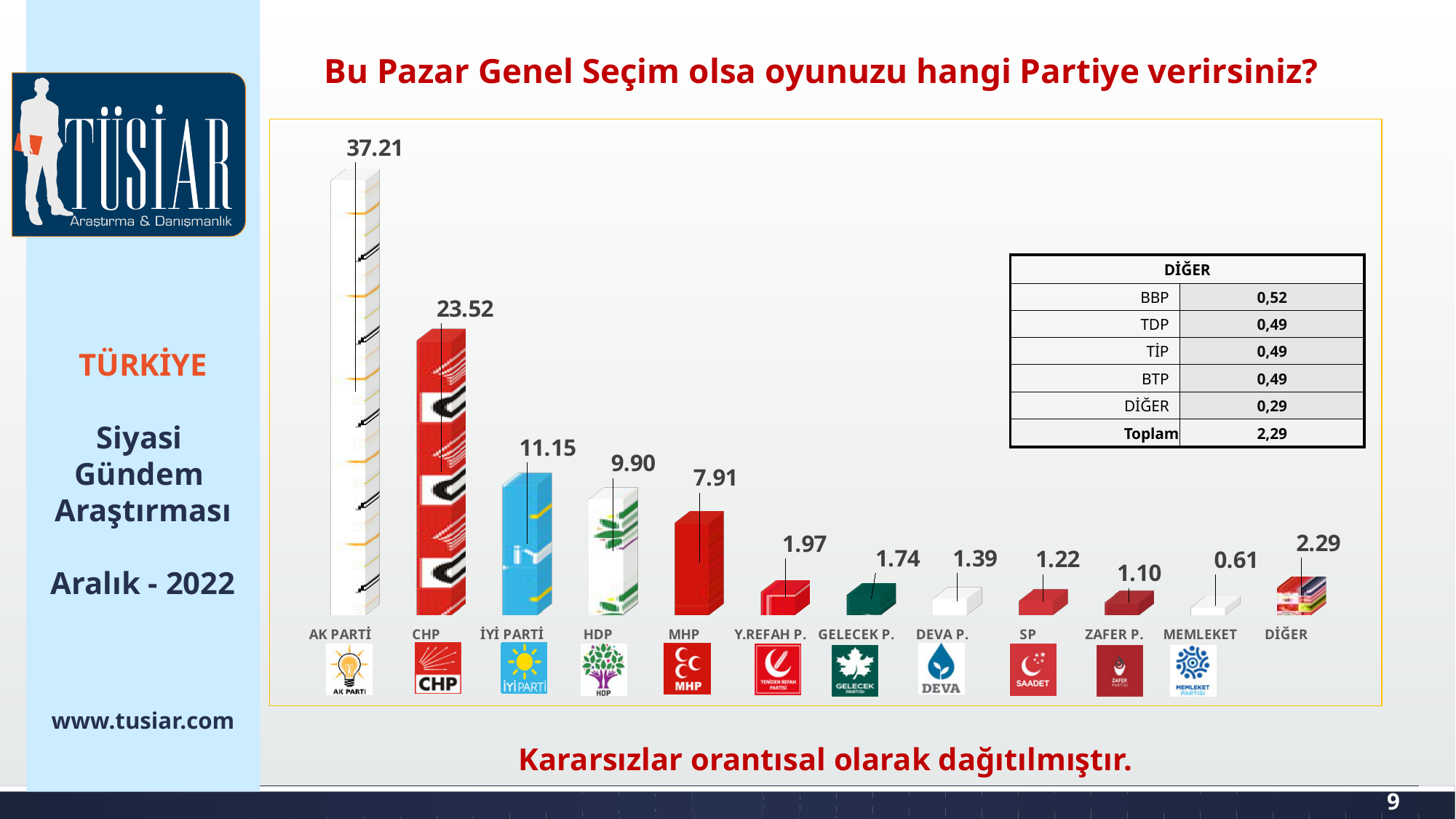
In the DİĞER table, what is the value shown for BBP? 0,52 What is the difference between the values for AK PARTİ and CHP? 13.69 Which party has the highest value in the chart? AK PARTİ Which is larger, the value for MHP or the value for HDP? HDP What value is shown for HDP? 9.90 Which party has the lowest value in the chart? MEMLEKET What is the difference between the values for İYİ PARTİ and HDP? 1.25 How many parties (categories) are shown in the bar chart? 12 What value is shown for MEMLEKET? 0.61 What value is shown for CHP? 23.52 What kind of chart is shown on the slide? Bar chart What value is shown for AK PARTİ? 37.21